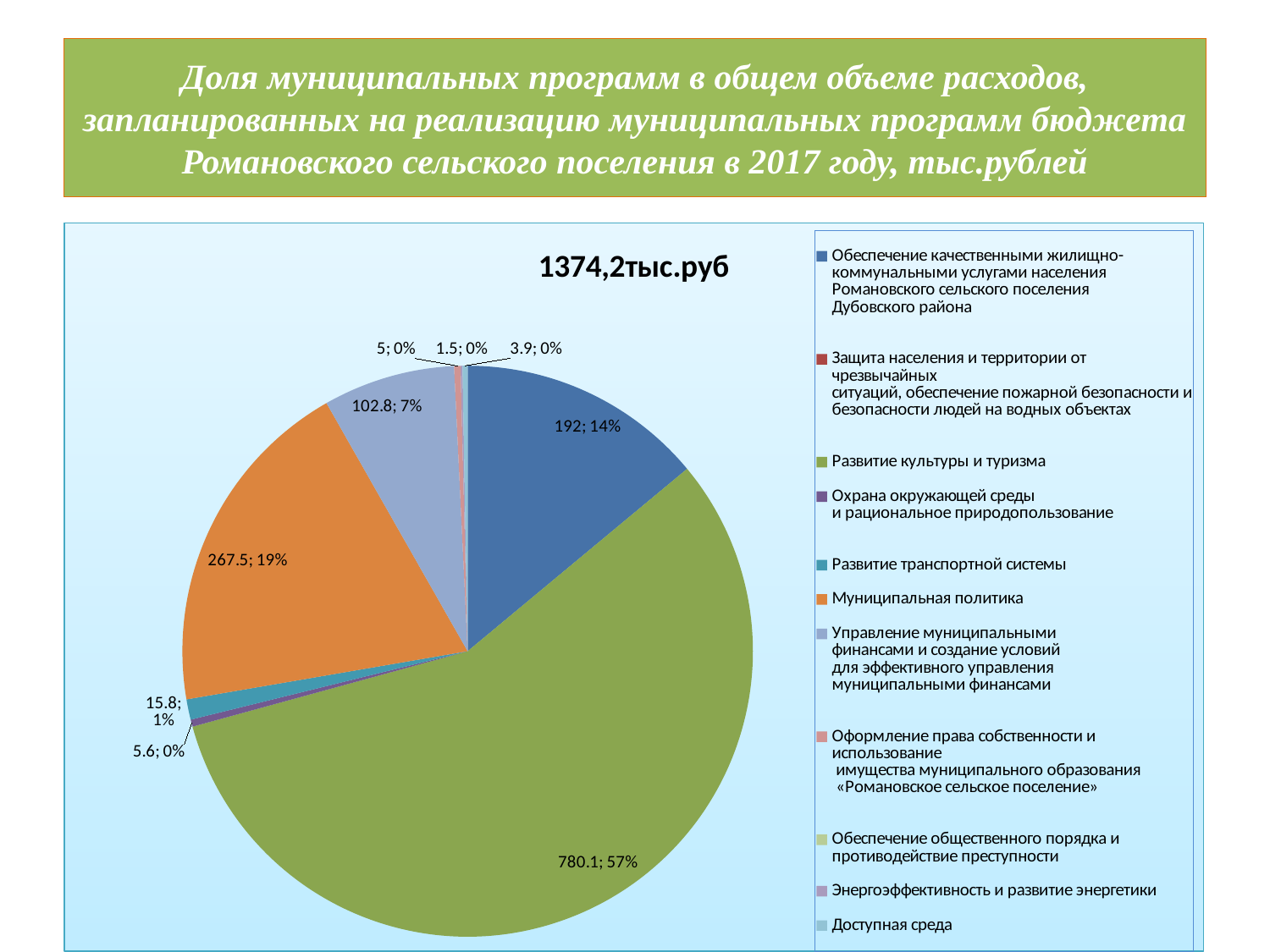
What share of the pie does "Муниципальная политика" take? 19% What value is shown for the slice "Развитие культуры и туризма"? 780.1 What value is shown for the slice "Развитие транспортной системы"? 15.8 Which category has the largest slice of the pie? Развитие культуры и туризма Which is larger: the value for "Муниципальная политика" or the value for "Обеспечение качественными жилищно-коммунальными услугами населения Романовского сельского поселения Дубовского района"? Муниципальная политика What kind of chart is shown on the slide? pie chart What value is shown for the slice "Обеспечение качественными жилищно-коммунальными услугами населения Романовского сельского поселения Дубовского района"? 192 What share of the pie does "Развитие культуры и туризма" take? 57% What value is shown for the slice "Муниципальная политика"? 267.5 What is the title shown above the pie chart? 1374,2тыс.руб What is the difference between the values for "Развитие культуры и туризма" and "Муниципальная политика"? 512.6 What value is shown for the slice "Управление муниципальными финансами и создание условий для эффективного управления муниципальными финансами"? 102.8